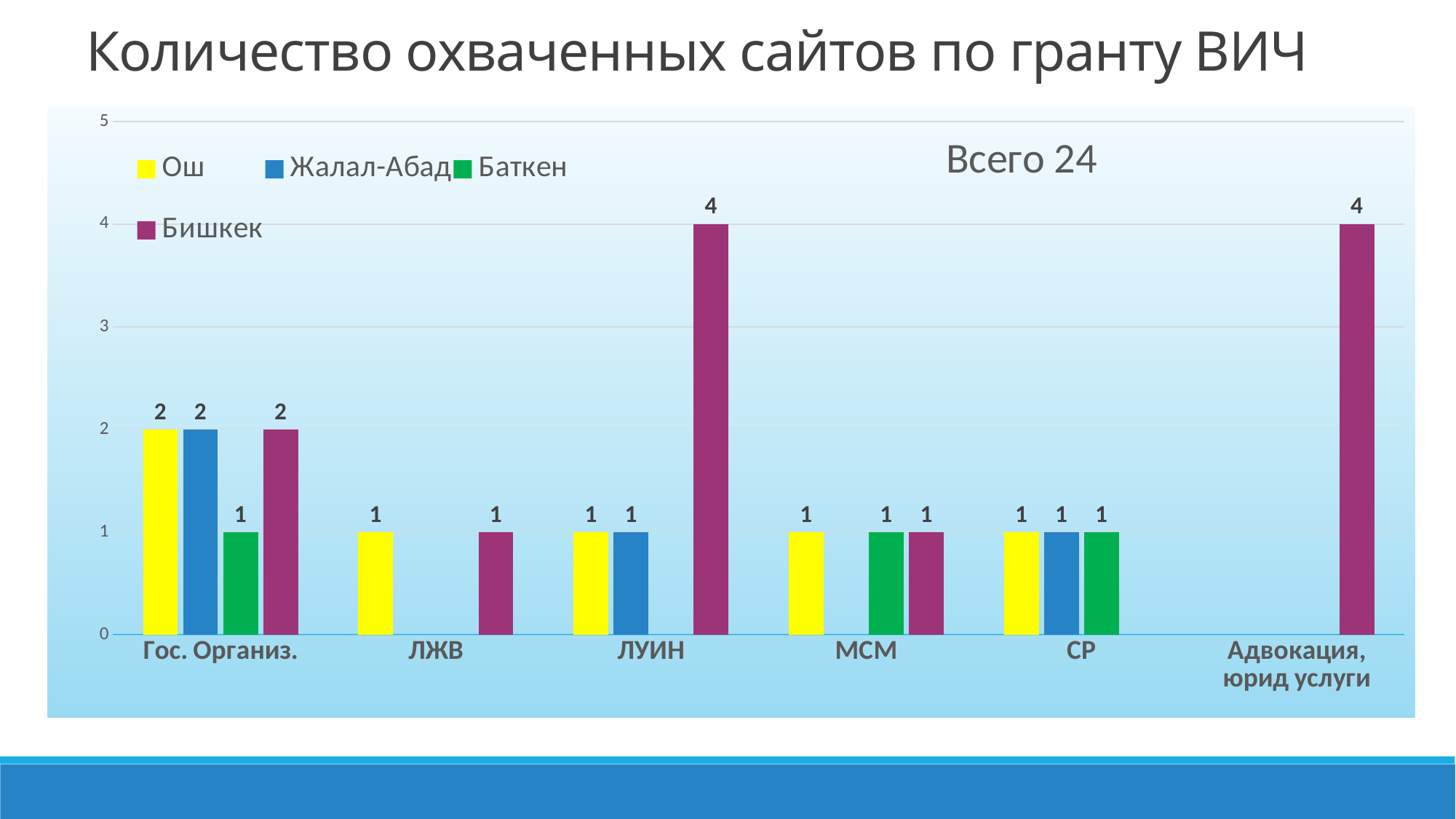
What is the value for Бишкек in the ЛУИН category? 4 What type of chart is shown on the slide? bar chart Which series has the highest value in the ЛУИН category? Бишкек What is the value for Баткен in the Гос. Организ. category? 1 Which is larger: the Ош value for Гос. Организ. or the Ош value for ЛЖВ? Гос. Организ. What is the value for Бишкек in the Адвокация, юрид услуги category? 4 What is the value for Ош in the Гос. Организ. category? 2 How many series does the legend list? 4 What is the difference between the Бишкек value for ЛУИН and the Бишкек value for Гос. Организ.? 2 What total is stated in the text inside the chart area? Всего 24 Which series is shown in yellow in the legend? Ош How many categories are shown on the x axis? 6